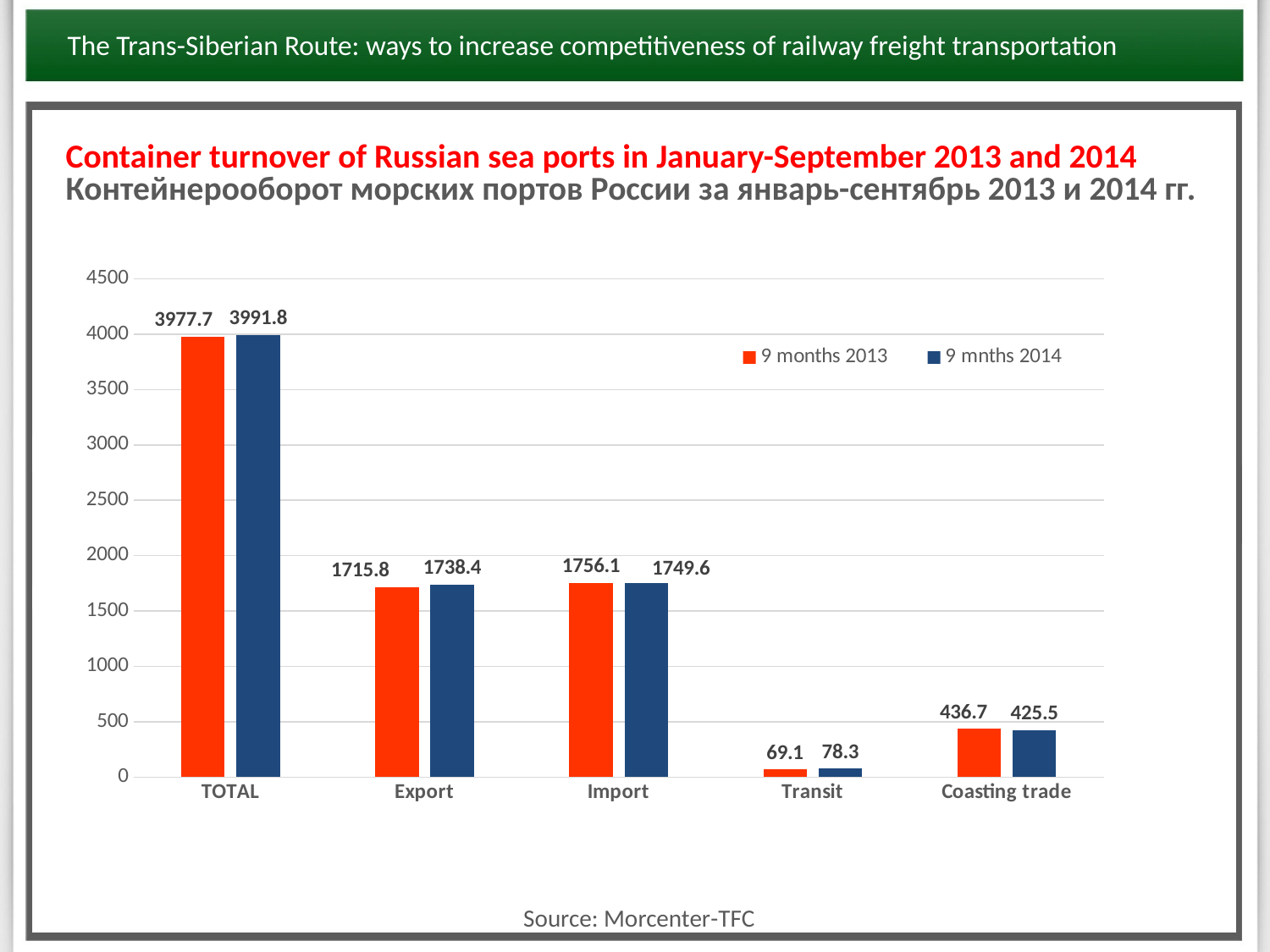
Excluding TOTAL, which category has the lowest value in the 9 months 2013 series? Transit How many categories are shown on the x axis? 5 What kind of chart is shown on the slide? bar chart Which is larger for Import: the 9 months 2013 value or the 9 mnths 2014 value? 9 months 2013 What is the difference between the 9 mnths 2014 and 9 months 2013 values for Export? 22.6 What is the value for TOTAL in the 9 mnths 2014 series? 3991.8 What is the value for Coasting trade in the 9 months 2013 series? 436.7 What is the value for Transit in the 9 mnths 2014 series? 78.3 How many series does the legend list? 2 What is the value for Export in the 9 months 2013 series? 1715.8 What is the difference between the 9 months 2013 and 9 mnths 2014 values for Coasting trade? 11.2 Is the 9 mnths 2014 value for Coasting trade greater or less than 500? less